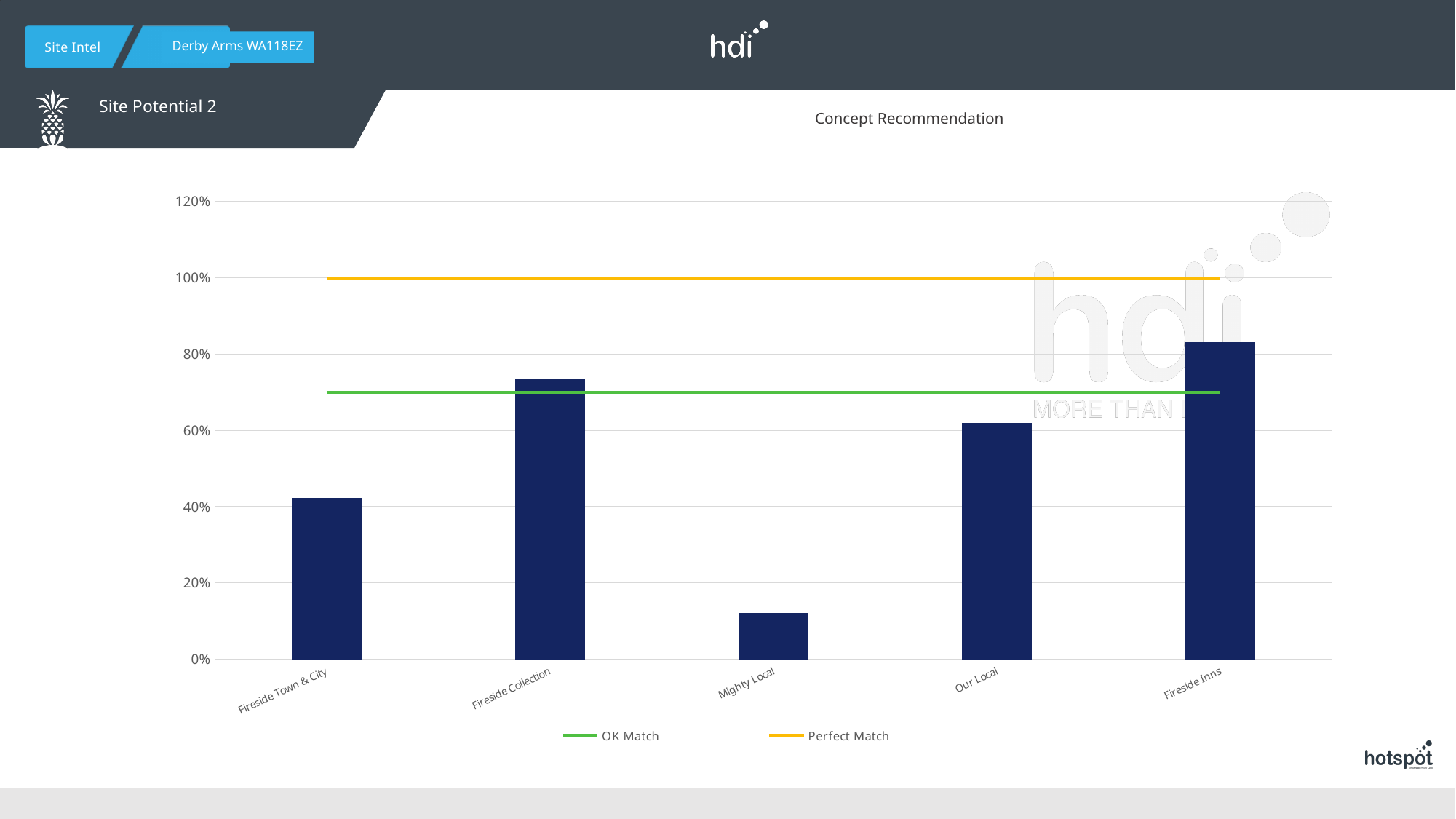
How many entries does the legend list? 2 Which is larger, the value for Fireside Collection or the value for Our Local? Fireside Collection How many categories are plotted along the x axis? 5 What is the title of the chart? Concept Recommendation What kind of chart is shown on the slide? bar chart Is the value for Our Local greater or less than 40%? greater Which category has the lowest bar? Mighty Local Is the value for Mighty Local greater or less than 20%? less Which is larger, the value for Fireside Town & City or the value for Mighty Local? Fireside Town & City Is the value for Fireside Town & City greater or less than 60%? less At what level is the Perfect Match line drawn? 100% Which category has the highest bar? Fireside Inns